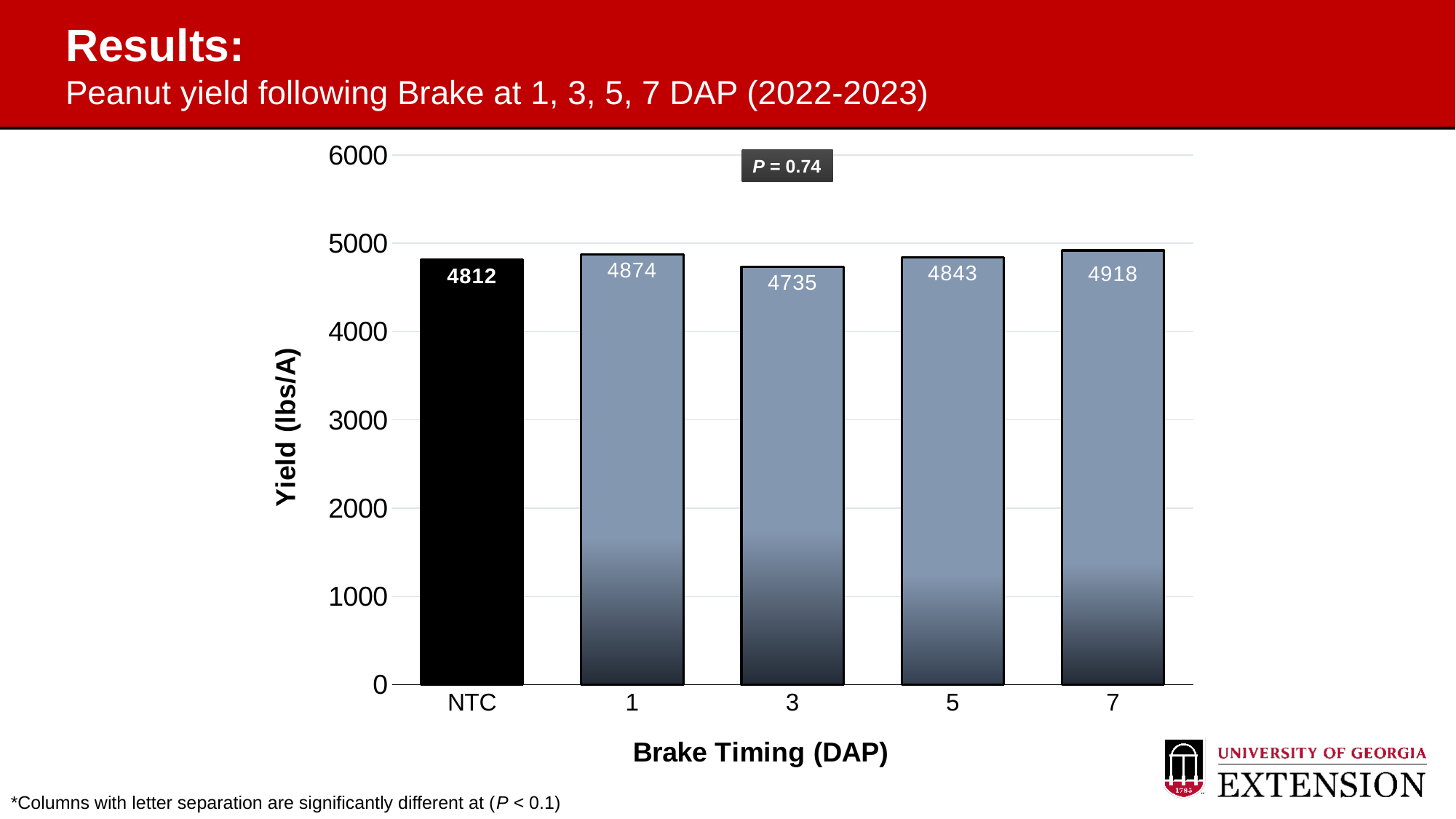
What is the difference in yield between the 7 DAP and 3 DAP treatments? 183 Which brake timing has the highest yield? 7 How many categories are shown on the x axis? 5 What is the peanut yield for the NTC treatment? 4812 What is the yield for Brake applied at 3 DAP? 4735 Which has a higher yield, 1 DAP or 5 DAP? 1 DAP What kind of chart is shown on the slide? bar chart Is the yield for the 5 DAP treatment greater or less than 5000? less What P value is shown on the chart? P = 0.74 What is the difference in yield between the 1 DAP treatment and NTC? 62 What is the yield for Brake applied at 7 DAP? 4918 Which category has the lowest yield? 3